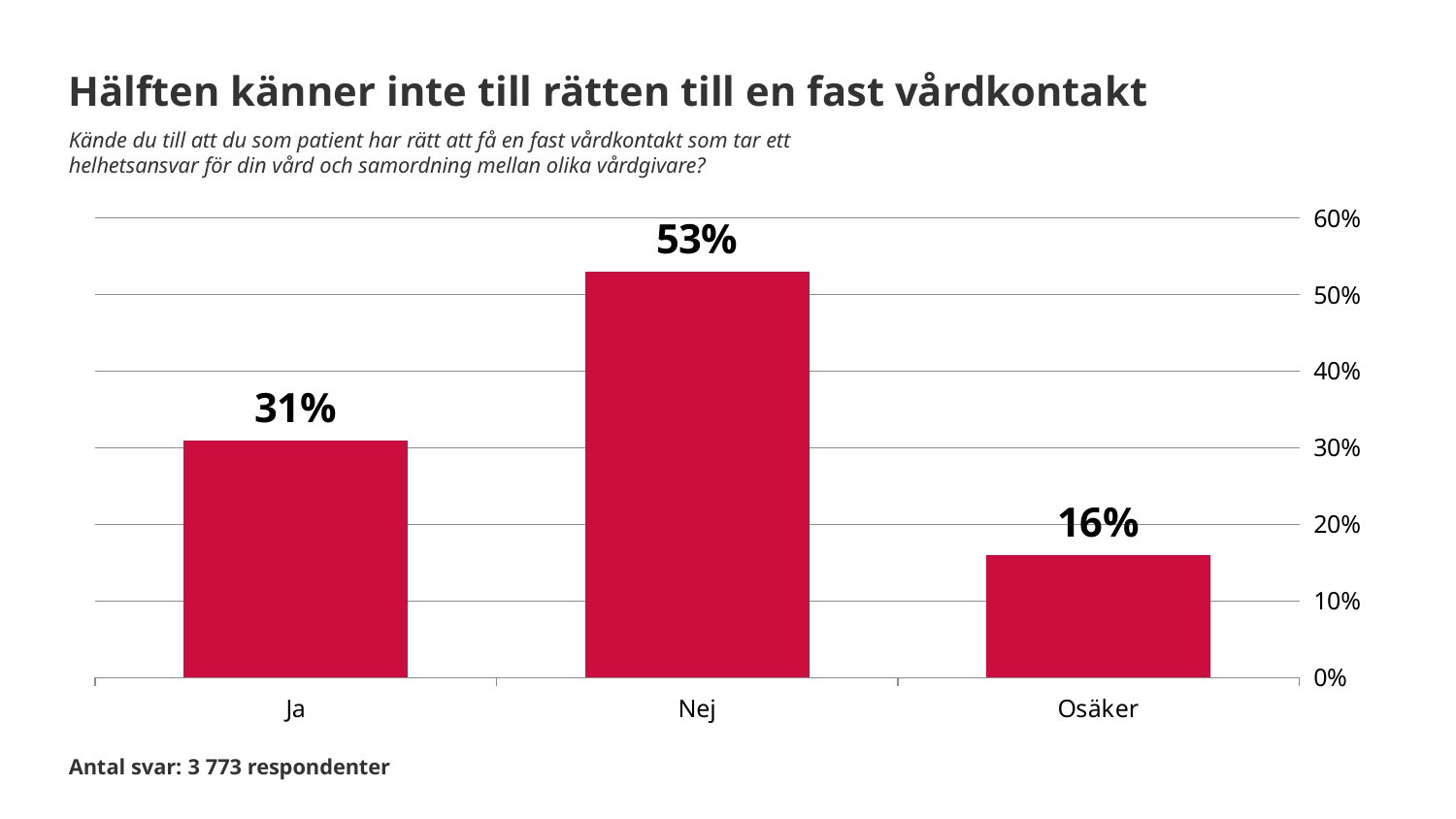
What is the value for Ja? 31% What is the difference between the values for Nej and Ja? 22% Which is larger, the value for Ja or the value for Osäker? Ja What kind of chart is shown on the slide? bar chart Is the value for Nej greater or less than 50%? greater What is the value for Osäker? 16% What is the title of the slide? Hälften känner inte till rätten till en fast vårdkontakt Which category has the lowest value? Osäker Which category has the highest value? Nej How many categories are shown on the x axis? 3 What is the difference between the values for Ja and Osäker? 15% What is the value for Nej? 53%